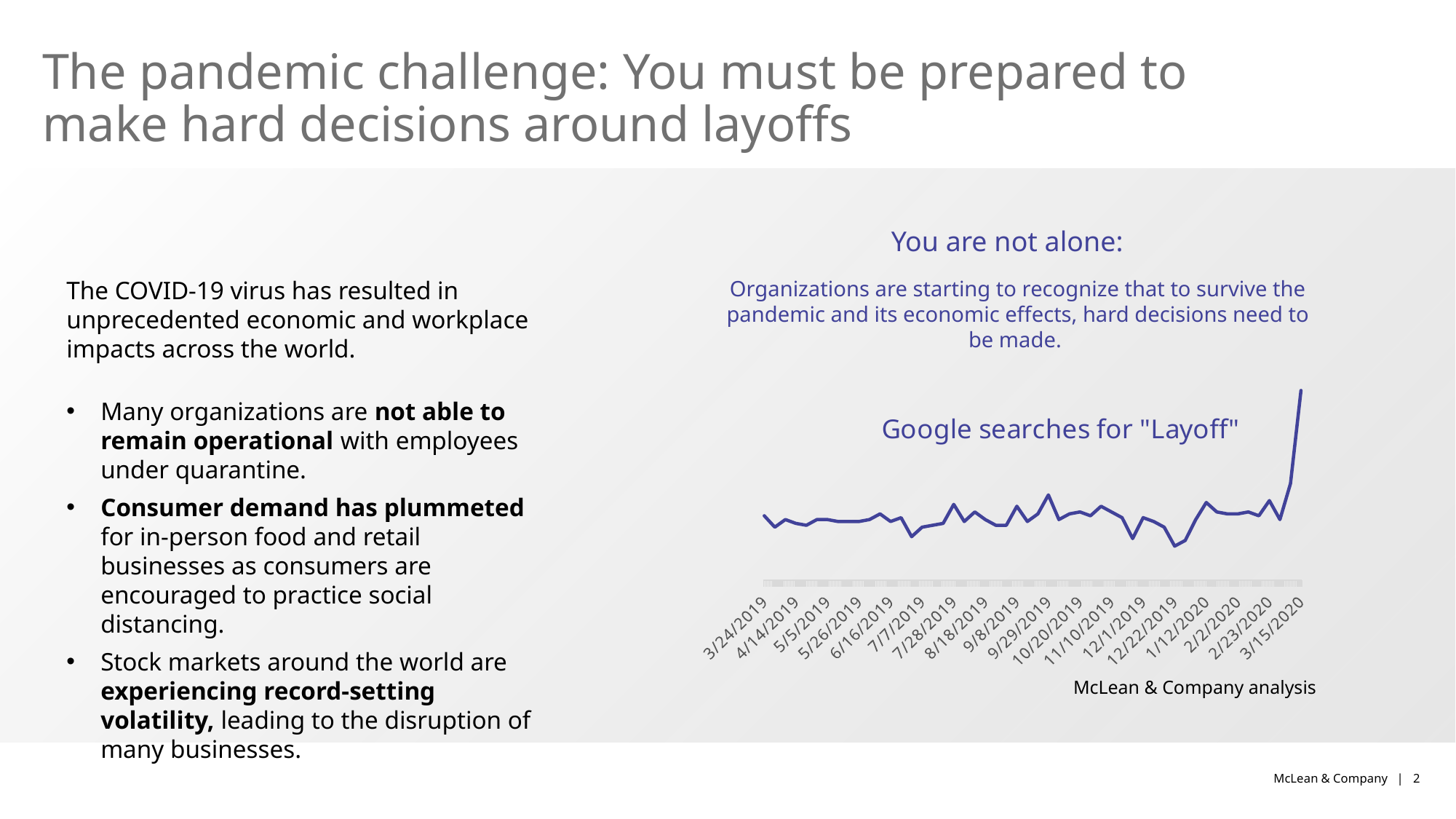
Is the value for Google searches for "Layoff" larger on 3/15/2020 or on 3/24/2019? 3/15/2020 What is the first date label on the x axis of the chart? 3/24/2019 How many data series are plotted in the chart? 1 How does the line for Google searches for "Layoff" behave at the right end of the x axis, in early 2020? rises sharply Which date on the x axis has the highest value for Google searches for "Layoff"? 3/15/2020 How many date labels are shown on the x axis of the chart? 18 Is the value for Google searches for "Layoff" larger on 3/15/2020 or on 12/22/2019? 3/15/2020 What is the last date label on the x axis of the chart? 3/15/2020 What kind of chart is shown on the slide? line chart What is the title of the chart on the slide? Google searches for "Layoff"